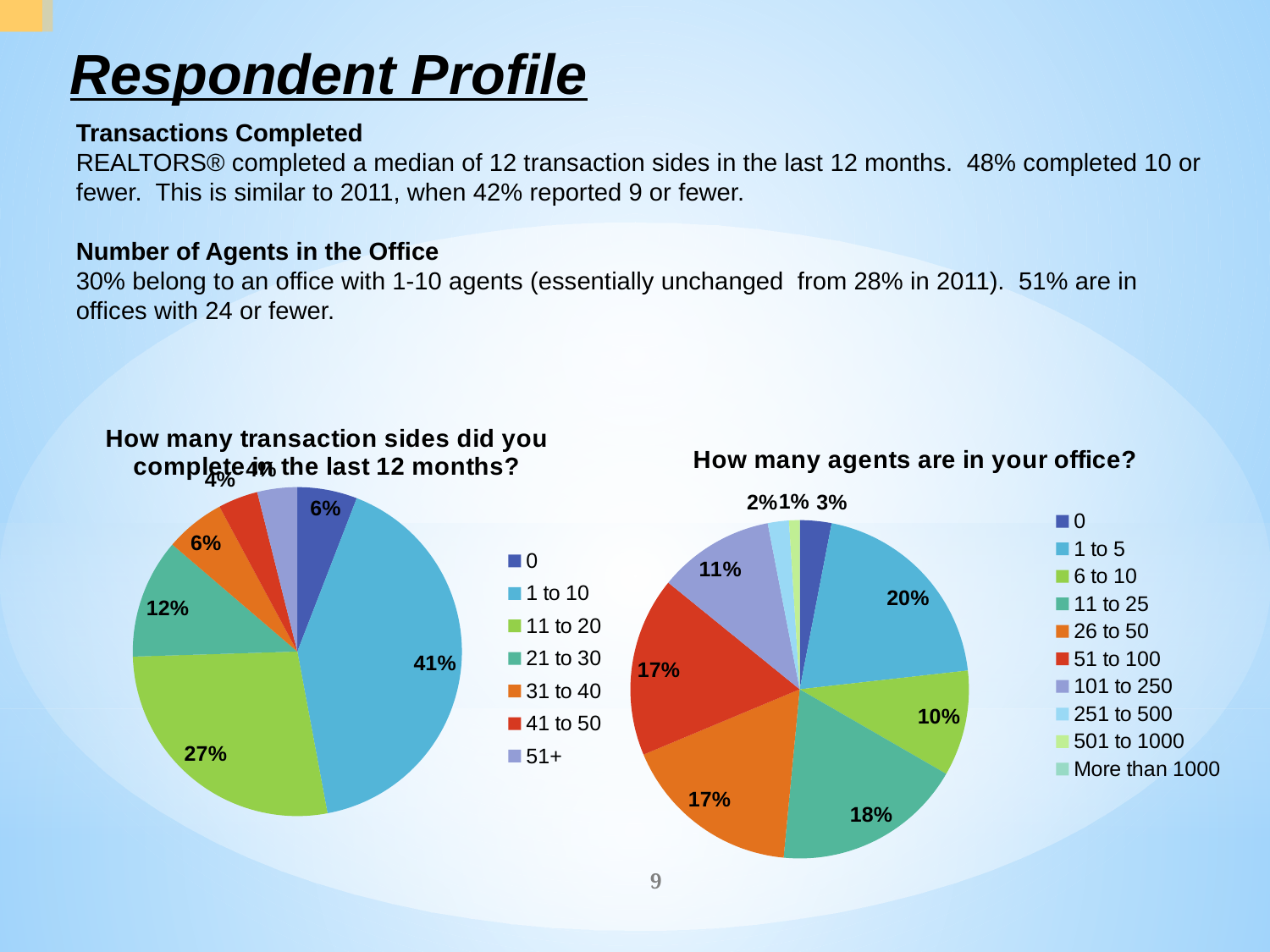
In the chart 'How many agents are in your office?', what share of respondents are in an office with 11 to 25 agents? 18% In the chart 'How many transaction sides did you complete in the last 12 months?', what share of respondents completed 1 to 10 transaction sides? 41% In the chart 'How many agents are in your office?', which category has the largest slice? 1 to 5 In the chart 'How many transaction sides did you complete in the last 12 months?', how many categories does the legend list? 7 In the chart 'How many transaction sides did you complete in the last 12 months?', how many percentage points larger is the '1 to 10' slice than the '11 to 20' slice? 14 percentage points In the chart 'How many transaction sides did you complete in the last 12 months?', what share of respondents completed 21 to 30 transaction sides? 12% In the chart 'How many agents are in your office?', what share of respondents are in an office with 1 to 5 agents? 20% In the chart 'How many transaction sides did you complete in the last 12 months?', what share of respondents completed 11 to 20 transaction sides? 27% In the chart 'How many agents are in your office?', which slice is larger: '6 to 10' or '11 to 25'? 11 to 25 In the chart 'How many transaction sides did you complete in the last 12 months?', which category has the largest slice? 1 to 10 In the chart 'How many agents are in your office?', what share of respondents are in an office with 101 to 250 agents? 11% What type of chart is used for 'How many agents are in your office?' Pie chart